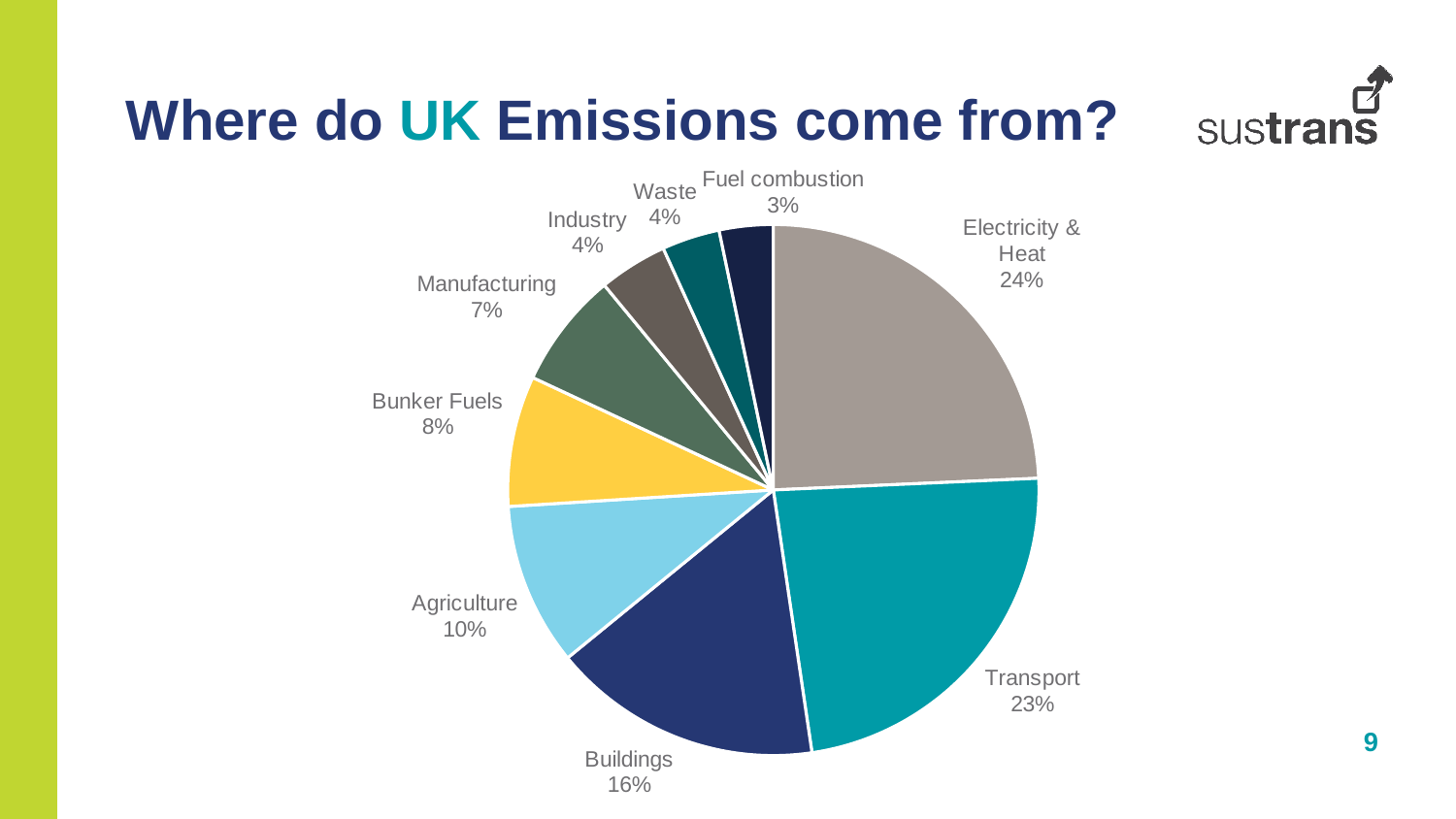
Which category has the largest share of UK emissions? Electricity & Heat Which category has the smallest share of UK emissions? Fuel combustion What type of chart is shown on the slide? Pie chart What share of UK emissions comes from Electricity & Heat? 24% What is the combined share of Electricity & Heat and Transport? 47% What percentage of emissions is attributed to Buildings? 16% What is the share for Bunker Fuels? 8% How many categories are shown in the pie chart? 9 Which has a larger share, Manufacturing or Agriculture? Agriculture What share of UK emissions comes from Transport? 23% What is the difference in percentage points between Buildings and Agriculture? 6 What is the title of the slide containing the chart? Where do UK Emissions come from?